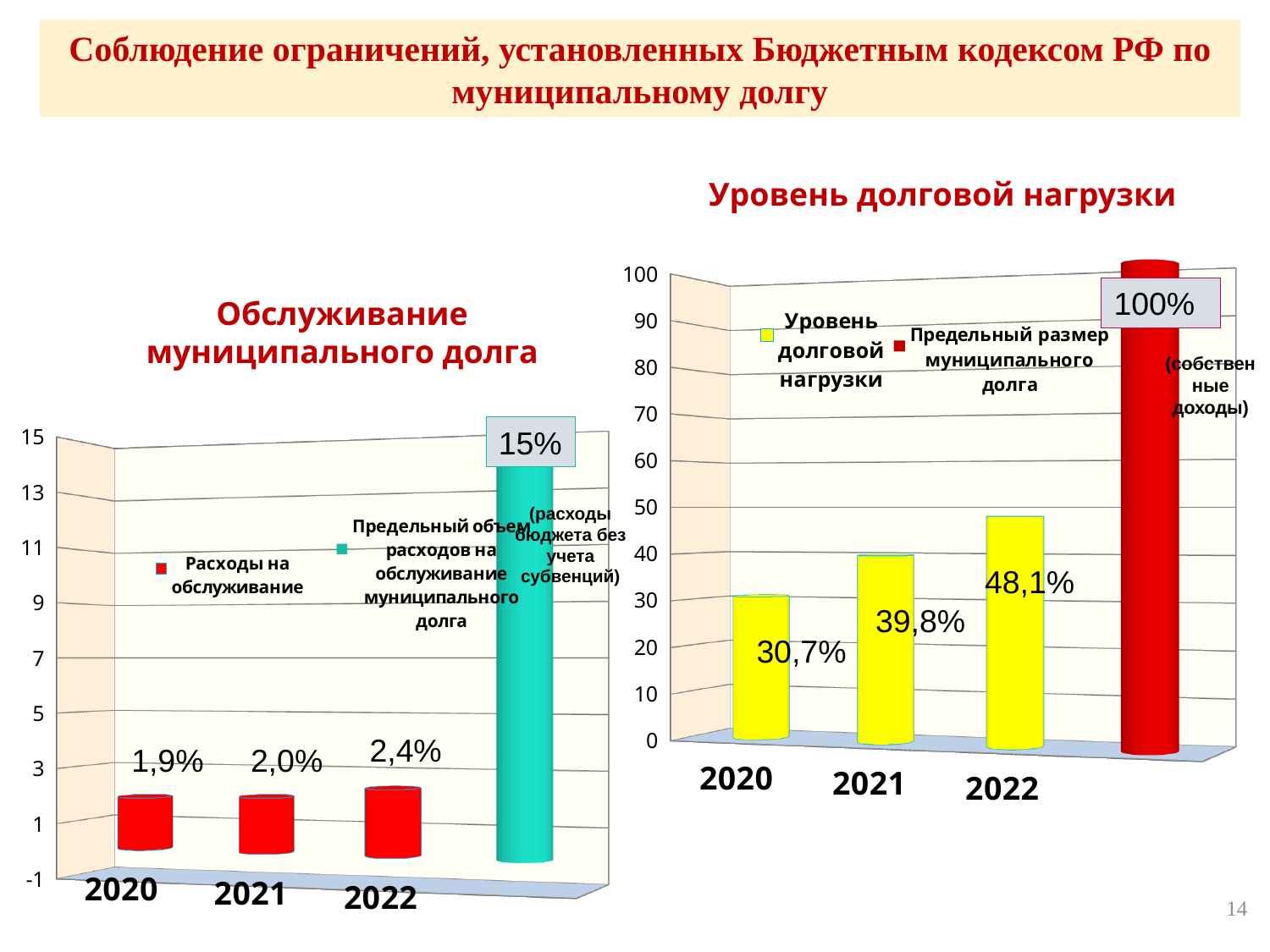
In the chart 'Уровень долговой нагрузки', what is the value for 2021? 39,8% In the chart 'Уровень долговой нагрузки', how many series does the legend list? 2 In the chart 'Обслуживание муниципального долга', what is the value for 2022? 2,4% In the chart 'Уровень долговой нагрузки', what is the value shown for 'Предельный размер муниципального долга'? 100% In the chart 'Уровень долговой нагрузки', which year has the lowest debt load level? 2020 In the chart 'Уровень долговой нагрузки', what is the value for 2022? 48,1% What kind of chart is 'Уровень долговой нагрузки'? bar chart In the chart 'Обслуживание муниципального долга', what is the value for 2020? 1,9% In the chart 'Обслуживание муниципального долга', what is the difference between the 2022 value and the 2020 value? 0,5% In the chart 'Уровень долговой нагрузки', what is the difference between the 2022 value and the 2021 value? 8,3% In the chart 'Обслуживание муниципального долга', what is the value shown for the limit bar 'Предельный объем расходов на обслуживание муниципального долга'? 15% In the chart 'Обслуживание муниципального долга', do the yearly values rise or fall from 2020 to 2022? rise